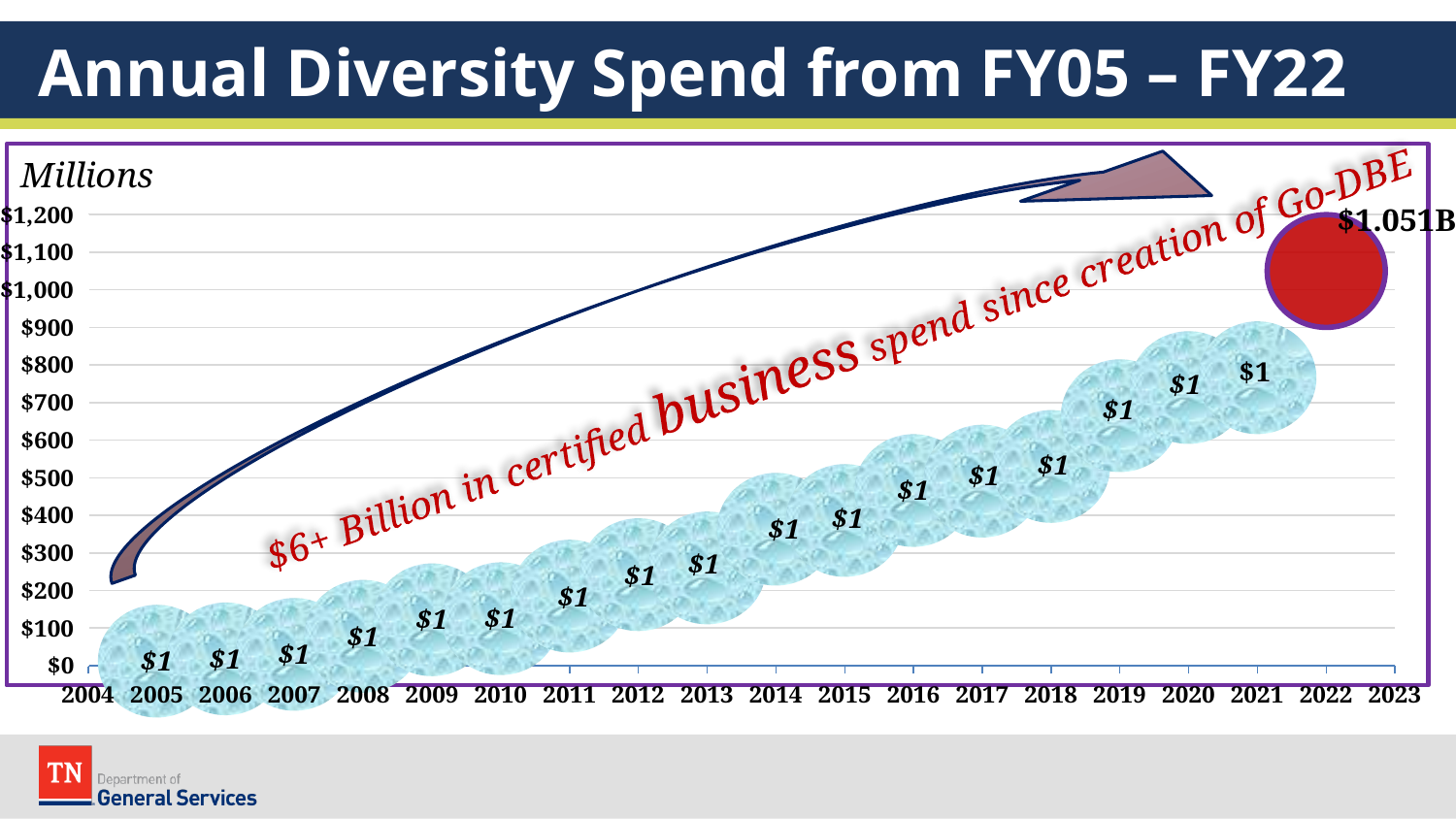
Do the values generally rise or fall from 2005 to 2022? rise Which year has the larger diversity spend, 2010 or 2021? 2021 How many years (data points) are plotted on the chart? 18 What value is labelled on the red data point for 2022? $1.051B Is the value for 2013 greater or less than $500? less Is the value for 2005 greater or less than $200? less Is the value for 2021 greater or less than $500? greater What unit label is shown at the top of the y axis? Millions What kind of chart is shown on the slide? bubble chart What is the title of the chart on the slide? Annual Diversity Spend from FY05 – FY22 Which year has the highest diversity spend on the chart? 2022